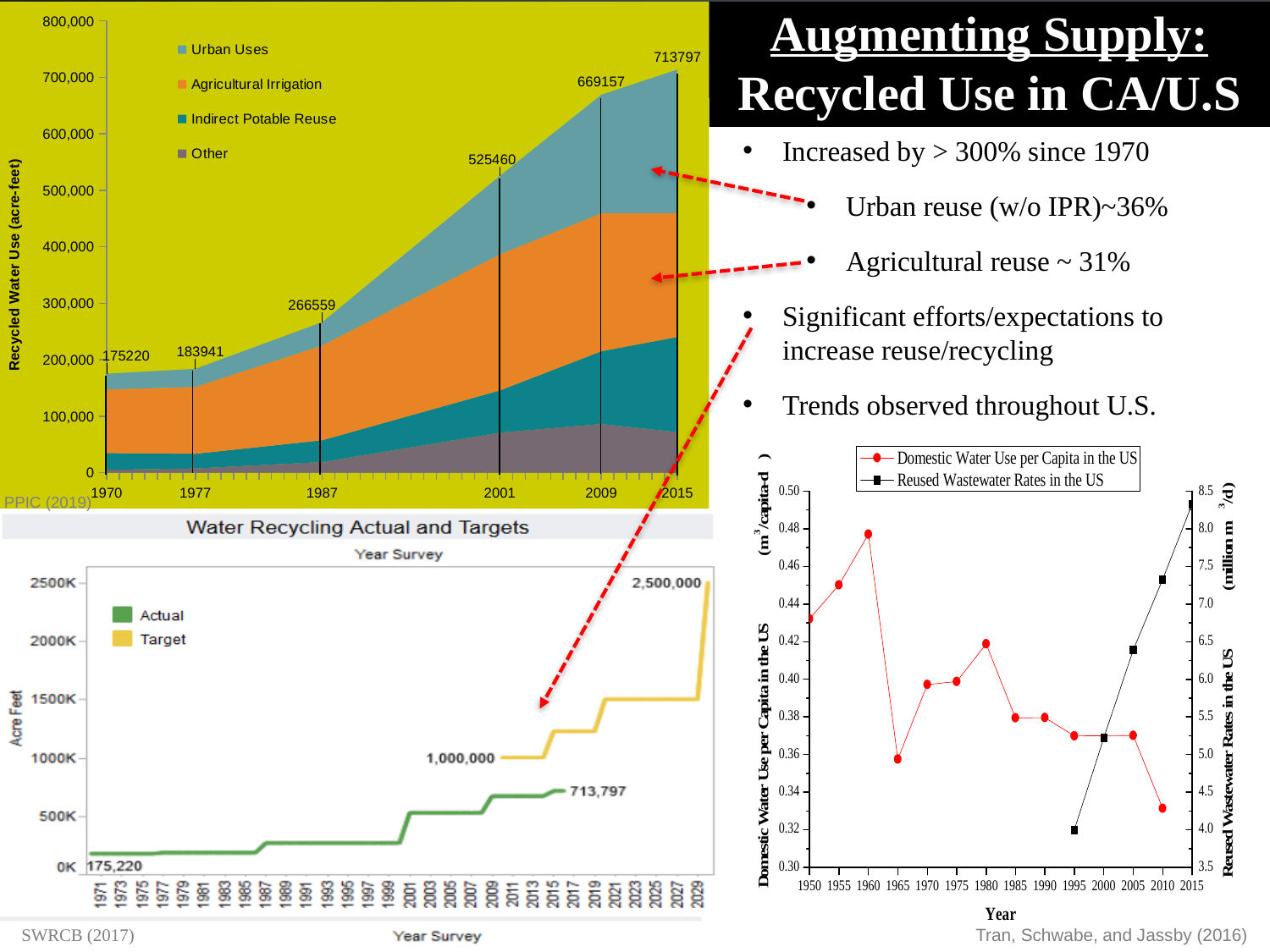
In the bottom-right chart, is the Reused Wastewater Rates value for 2015 greater or less than 8.0? greater In the top-left chart of recycled water use, what value is labelled for 2015? 713797 In the top-left chart of recycled water use, what value is labelled for 2001? 525460 In the top-left chart of recycled water use, how many series does the legend list? 4 In the 'Water Recycling Actual and Targets' chart, what is the highest labelled Target value? 2,500,000 In the 'Water Recycling Actual and Targets' chart, how many series does the legend list? 2 In the bottom-right chart, do the Reused Wastewater Rates in the US rise or fall from 1995 to 2015? rise In the top-left chart of recycled water use, which labelled year has the lowest total? 1970 In the top-left chart of recycled water use, what is the difference between the labelled totals for 2015 and 2009? 44640 In the top-left chart of recycled water use, what value is labelled for 1970? 175220 In the 'Water Recycling Actual and Targets' chart, what is the last labelled Actual value? 713,797 In the top-left chart of recycled water use, do the labelled totals rise or fall from 1970 to 2015? rise